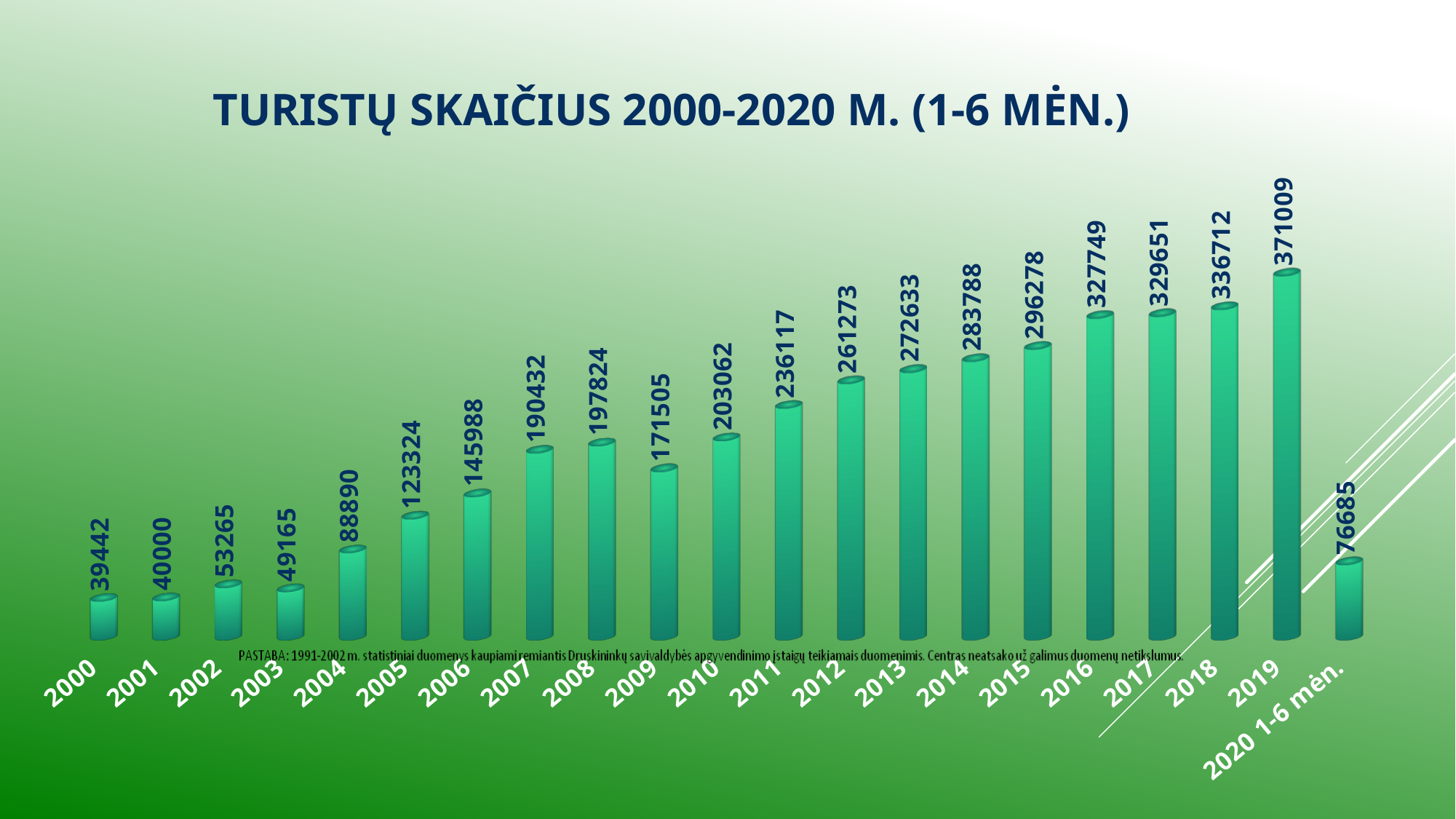
Which category has the lowest value on the chart? 2000 What is the title of the chart? TURISTŲ SKAIČIUS 2000-2020 M. (1-6 MĖN.) What value is shown for 2020 1-6 mėn.? 76685 What value is shown for 2000? 39442 What is the difference between the values for 2001 and 2000? 558 What kind of chart is shown on the slide? bar chart Which is larger, the value for 2008 or the value for 2009? 2008 Which year has the highest value on the chart? 2019 What is the number of tourists shown for 2019? 371009 What is the difference between the values for 2019 and 2018? 34297 What value is shown for 2009? 171505 How many bars are shown on the chart? 21